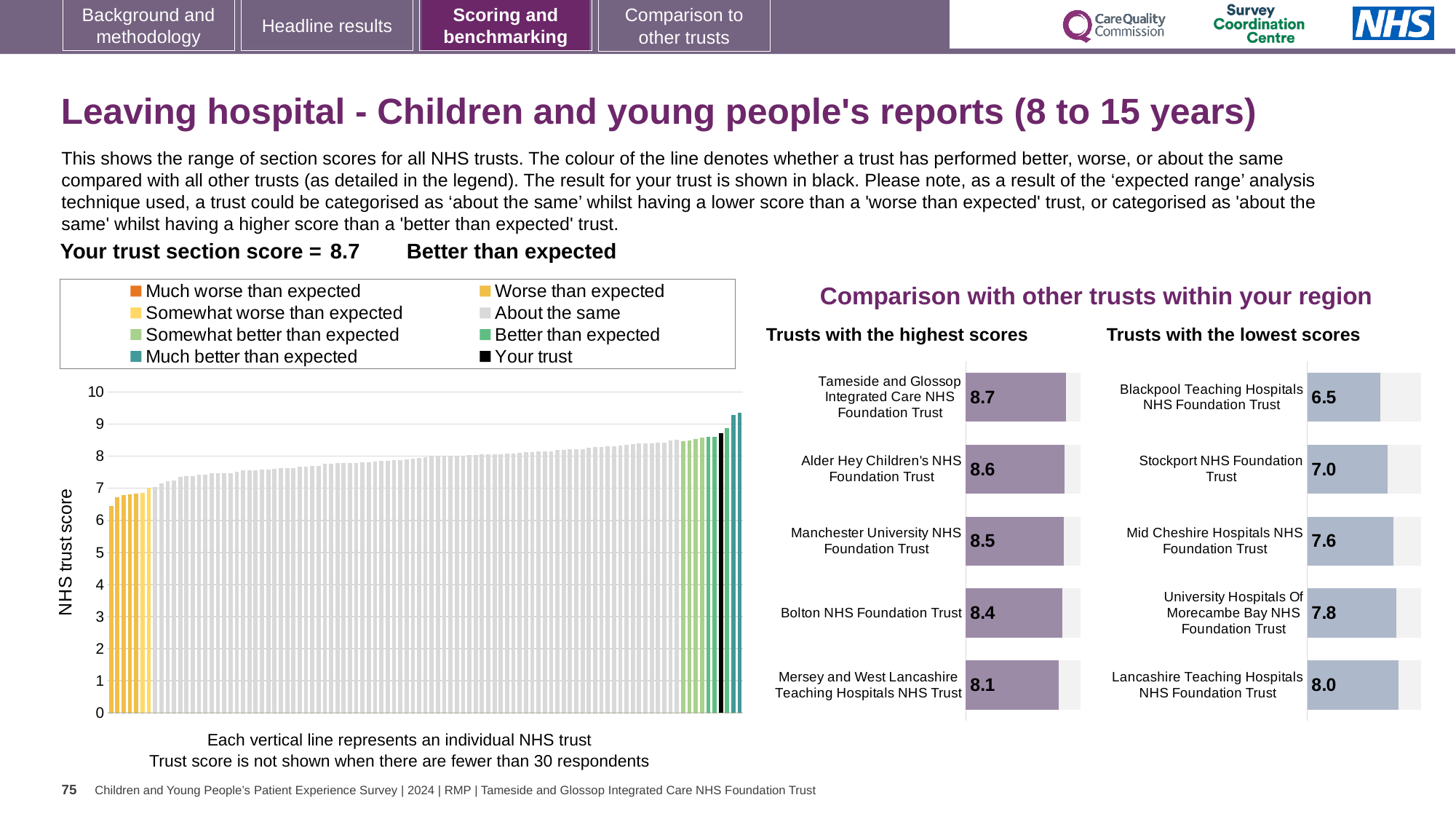
In the 'Trusts with the highest scores' chart, what is the difference between the scores of Tameside and Glossop Integrated Care NHS Foundation Trust and Mersey and West Lancashire Teaching Hospitals NHS Trust? 0.6 What kind of chart is the main 'NHS trust score' chart on the left? Bar chart In the 'Trusts with the lowest scores' chart, what is the difference between the scores of Lancashire Teaching Hospitals NHS Foundation Trust and Blackpool Teaching Hospitals NHS Foundation Trust? 1.5 In the 'Trusts with the highest scores' chart, which trust has the highest score? Tameside and Glossop Integrated Care NHS Foundation Trust In the main 'NHS trust score' chart on the left, is the value of the black 'Your trust' bar greater or less than 8? greater How many trusts are shown in the 'Trusts with the highest scores' chart? 5 In the 'Trusts with the lowest scores' chart, which trust has the lowest score? Blackpool Teaching Hospitals NHS Foundation Trust In the 'Trusts with the highest scores' chart, what is the score for Alder Hey Children's NHS Foundation Trust? 8.6 How many entries does the legend above the main 'NHS trust score' chart list? 8 In the main 'NHS trust score' chart on the left, is the value of the tallest bar greater or less than 9? greater In the 'Trusts with the lowest scores' chart, what is the score for Stockport NHS Foundation Trust? 7.0 In the 'Trusts with the lowest scores' chart, which has the higher score: Mid Cheshire Hospitals NHS Foundation Trust or University Hospitals Of Morecambe Bay NHS Foundation Trust? University Hospitals Of Morecambe Bay NHS Foundation Trust